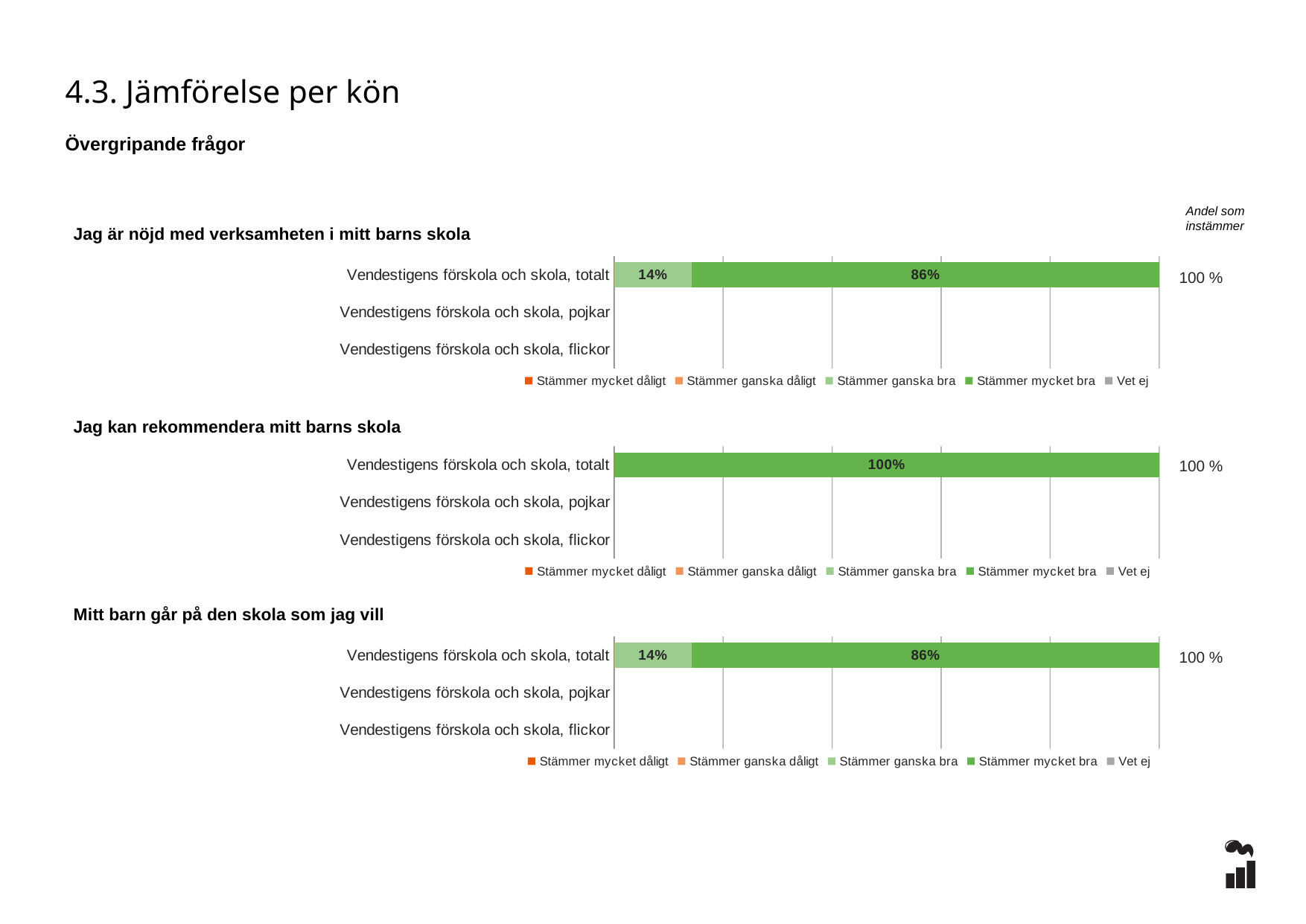
What kind of chart is 'Jag kan rekommendera mitt barns skola'? Stacked bar chart How many series does the legend of the chart 'Jag kan rekommendera mitt barns skola' list? 5 In the chart 'Mitt barn går på den skola som jag vill', what is the value for 'Stämmer mycket bra' for Vendestigens förskola och skola, totalt? 86% What is the 'Andel som instämmer' value shown for the totalt row in the chart 'Jag kan rekommendera mitt barns skola'? 100 % In the chart 'Mitt barn går på den skola som jag vill', what is the total of the totalt stacked bar? 100% How many categories are shown on the y axis of the chart 'Jag är nöjd med verksamheten i mitt barns skola'? 3 In the chart 'Jag är nöjd med verksamheten i mitt barns skola', what is the value for 'Stämmer ganska bra' for Vendestigens förskola och skola, totalt? 14% In the chart 'Jag kan rekommendera mitt barns skola', what is the value for 'Stämmer mycket bra' for Vendestigens förskola och skola, totalt? 100% In the chart 'Jag är nöjd med verksamheten i mitt barns skola', what is the value for 'Stämmer mycket bra' for Vendestigens förskola och skola, totalt? 86% In the chart 'Jag är nöjd med verksamheten i mitt barns skola', which is larger for the totalt bar: 'Stämmer ganska bra' or 'Stämmer mycket bra'? Stämmer mycket bra In the chart 'Jag är nöjd med verksamheten i mitt barns skola', what is the difference between the 'Stämmer mycket bra' and 'Stämmer ganska bra' values for the totalt bar? 72% In the chart 'Mitt barn går på den skola som jag vill', what is the value for 'Stämmer ganska bra' for Vendestigens förskola och skola, totalt? 14%